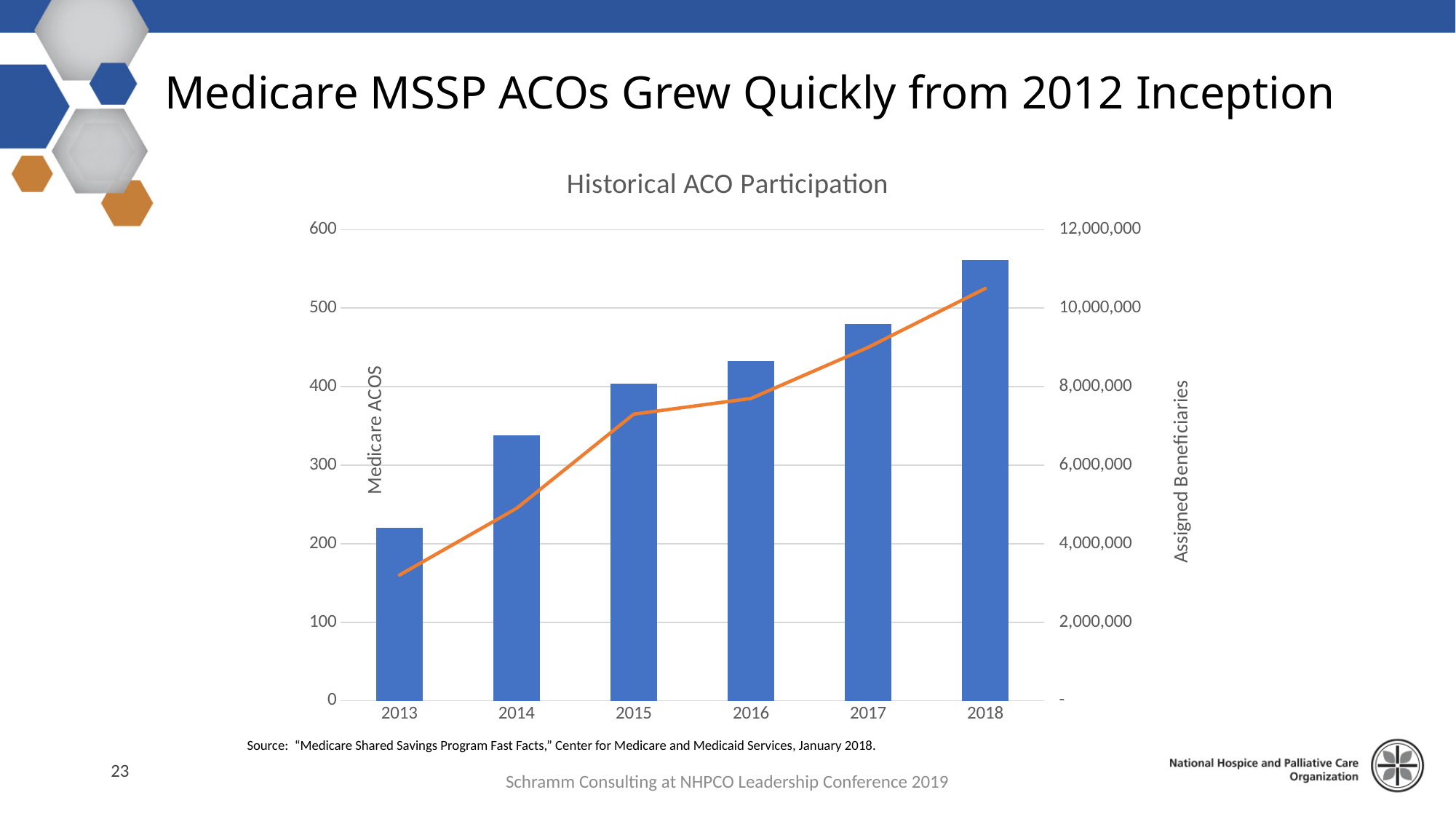
Which year has the shortest bar for Medicare ACOs? 2013 Is the number of Medicare ACOs in 2013 greater or less than 300? less What is the label of the right-hand vertical axis? Assigned Beneficiaries Is the number of Assigned Beneficiaries in 2018 greater or less than 10,000,000? greater Do the Medicare ACOs bars rise or fall from 2013 to 2018? Rise How many years are shown on the x axis of the chart? 6 Which year has more Medicare ACOs, 2015 or 2017? 2017 Is the number of Medicare ACOs in 2018 greater or less than 500? greater What kind of chart is shown on the slide? A bar chart combined with a line chart What is the title of the chart? Historical ACO Participation Which year has the tallest bar for Medicare ACOs? 2018